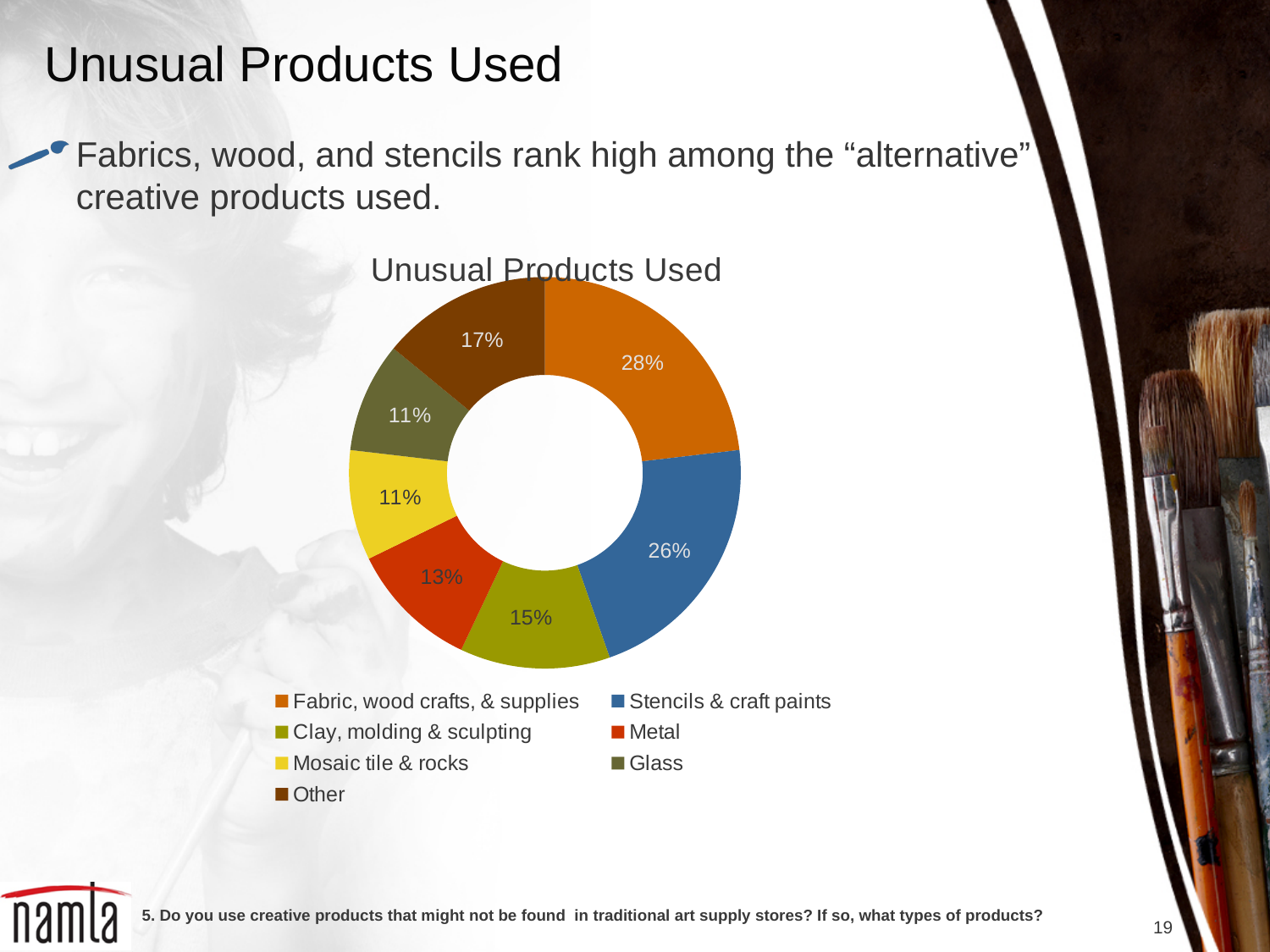
What percentage is shown for Clay, molding & sculpting? 15% What kind of chart is shown on the slide? Doughnut chart Which category has the largest share of the chart? Fabric, wood crafts, & supplies What percentage is shown for Stencils & craft paints? 26% What is the difference in percentage points between Fabric, wood crafts, & supplies and Stencils & craft paints? 2 What percentage of the chart is Fabric, wood crafts, & supplies? 28% What is the title of the chart? Unusual Products Used What colour represents Stencils & craft paints in the chart? Blue Which is larger, the share for Metal or the share for Other? Other How many categories does the legend list? 7 What percentage is shown for Other? 17% What percentage is shown for Metal? 13%